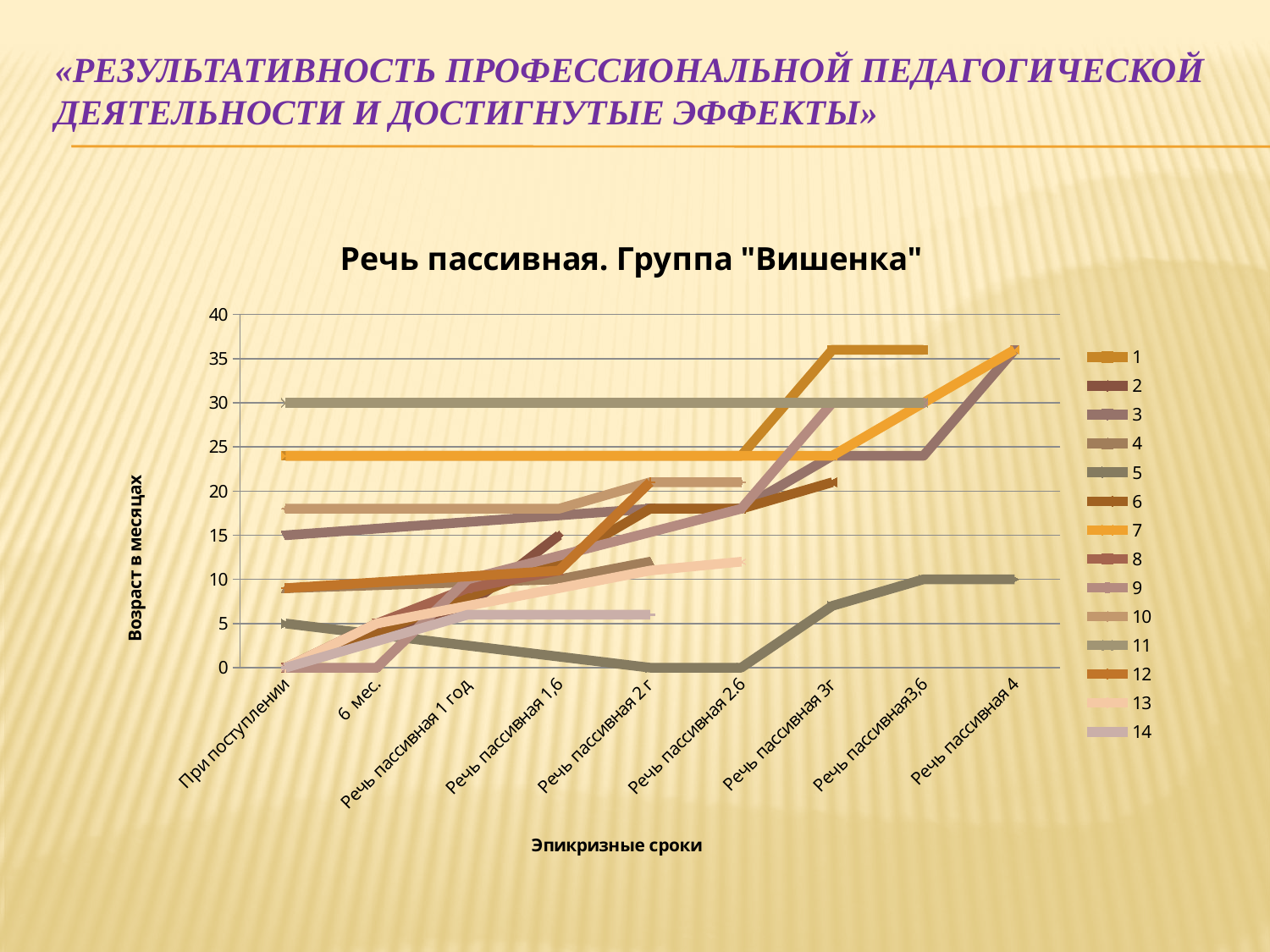
What is the value of series 3 at "При поступлении"? 15 What is the value of series 5 at "Речь пассивная 4"? 10 What is the title of the chart? Речь пассивная. Группа "Вишенка" How many series does the legend list? 14 What kind of chart is shown on the slide? line chart Which series has the highest value at "При поступлении"? 11 Is the value for series 7 at "При поступлении" greater or less than 25? less How many categories are shown along the x axis? 9 Which series has the lowest value at "Речь пассивная 4"? 5 What is the label of the vertical axis? Возраст в месяцах Is the value for series 1 at "Речь пассивная 3г" greater or less than 35? greater What is the value of series 11 at "При поступлении"? 30